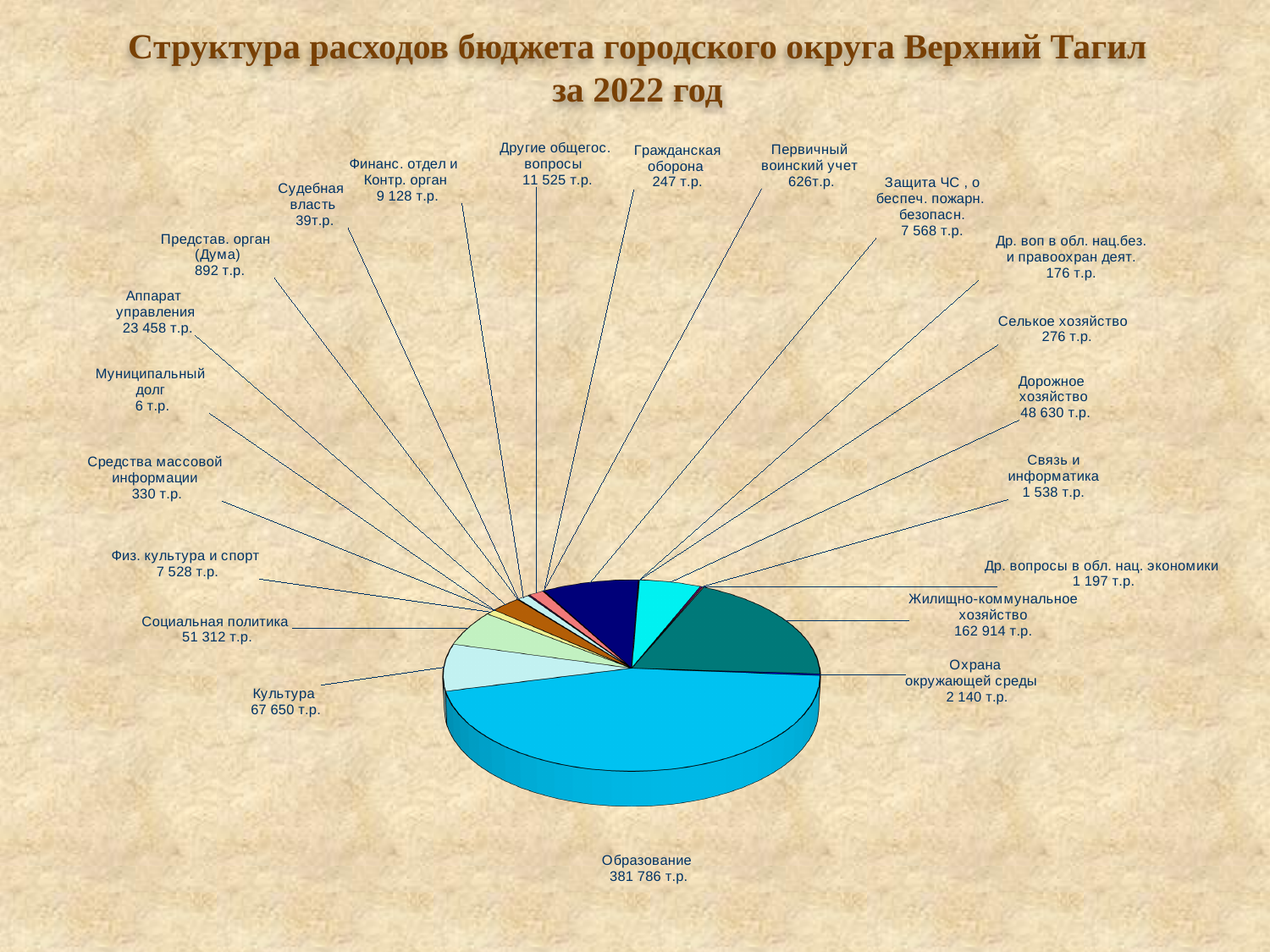
What is the title of the chart? Структура расходов бюджета городского округа Верхний Тагил за 2022 год What is the value shown for Образование? 381 786 т.р. What is the value shown for Дорожное хозяйство? 48 630 т.р. Which is larger, the value for Культура or the value for Дорожное хозяйство? Культура Which category has the largest share of the pie? Образование What is the value shown for Жилищно-коммунальное хозяйство? 162 914 т.р. What is the difference between the values for Образование and Жилищно-коммунальное хозяйство? 218 872 т.р. Which category has the smallest value shown on the chart? Муниципальный долг What is the value shown for Социальная политика? 51 312 т.р. How many categories are labelled on the pie chart? 21 What is the difference between the values for Культура and Социальная политика? 16 338 т.р. What kind of chart is shown on the slide? Pie chart